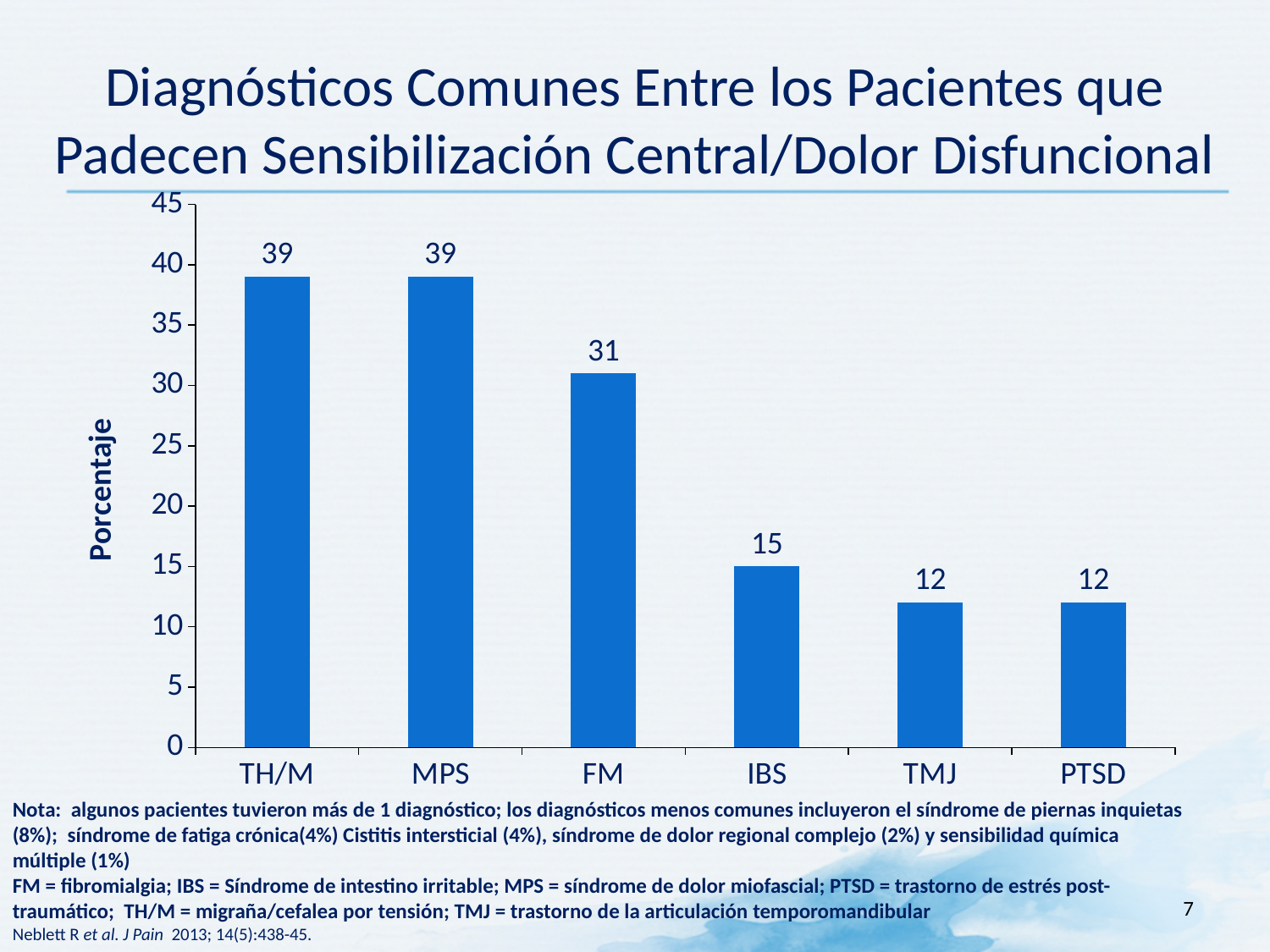
What is the label of the y axis? Porcentaje Do the values rise or fall from TH/M to PTSD along the x axis? fall What is the value for TMJ? 12 What is the value for MPS? 39 How many categories are shown on the x axis? 6 Which category has the lowest value, FM or IBS? IBS What is the difference between the values for IBS and PTSD? 3 What is the difference between the values for TH/M and FM? 8 What kind of chart is shown on the slide? bar chart Is the value for FM greater or less than 30? greater What is the value for FM? 31 What is the value for IBS? 15